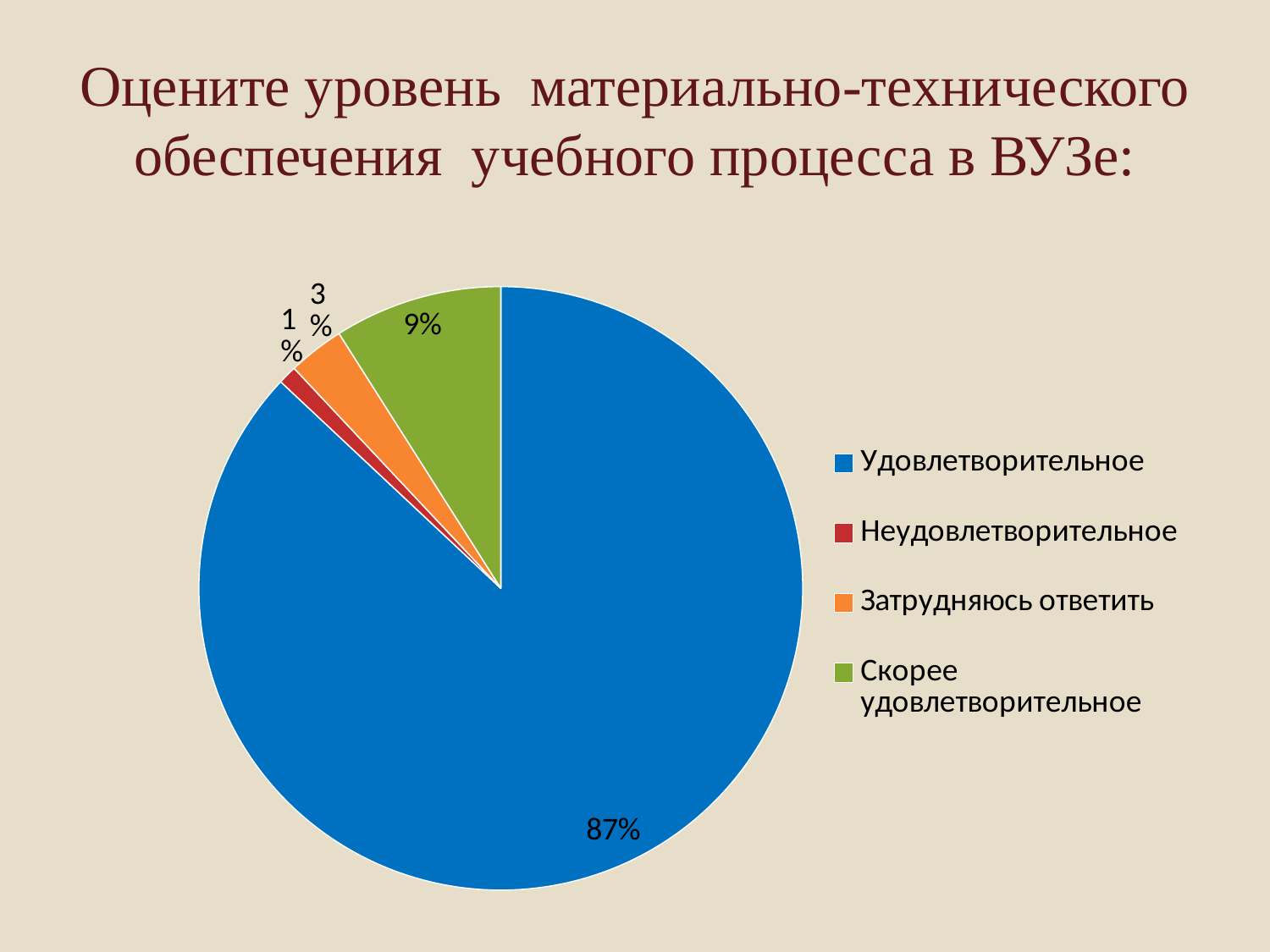
What share of the pie is labelled "Неудовлетворительное"? 1% Which category has the smallest slice of the pie? Неудовлетворительное What share of the pie is labelled "Скорее удовлетворительное"? 9% What colour is the slice for "Затрудняюсь ответить"? orange What is the difference in percentage points between "Удовлетворительное" and "Скорее удовлетворительное"? 78 What kind of chart is shown on the slide? pie chart What share of the pie is labelled "Затрудняюсь ответить"? 3% Which is larger: the share for "Затрудняюсь ответить" or the share for "Скорее удовлетворительное"? Скорее удовлетворительное How many slices does the pie chart have? 4 How many entries does the legend list? 4 What share of the pie is labelled "Удовлетворительное"? 87% Which category has the largest slice of the pie? Удовлетворительное